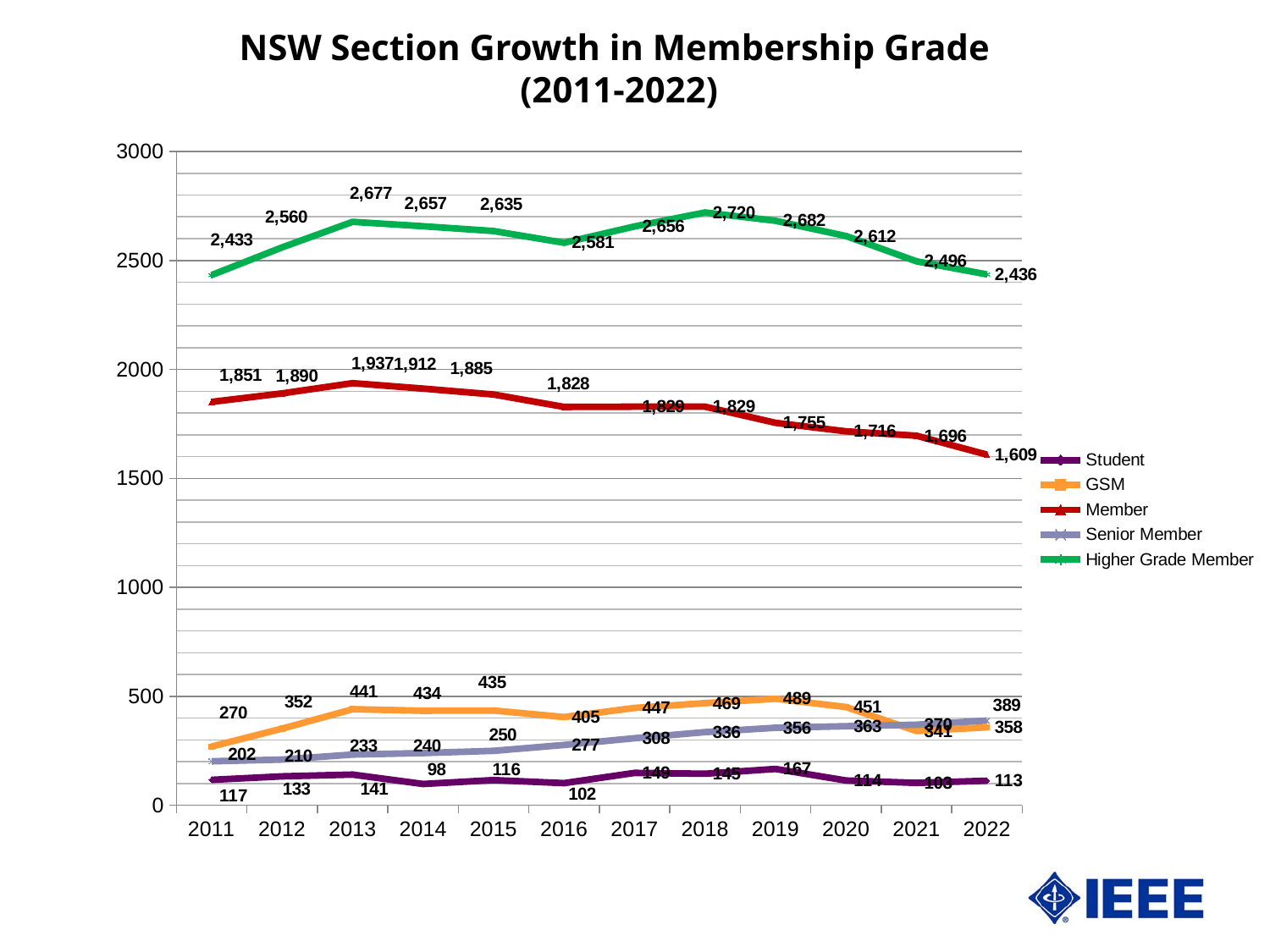
What is the difference between the Member values for 2013 and 2022? 328 What is the Member value for 2022? 1,609 What is the GSM value for 2019? 489 In which year does the Higher Grade Member series reach its highest value? 2018 What type of chart is shown on the slide? Line chart In which year is the Member series at its lowest value? 2022 How many series does the legend list? 5 Which is larger in 2022, the GSM value or the Senior Member value? Senior Member How many years are plotted along the x axis? 12 Does the Senior Member series rise or fall from 2011 to 2022? Rise What is the Senior Member value for 2022? 389 What is the Higher Grade Member value for 2011? 2,433